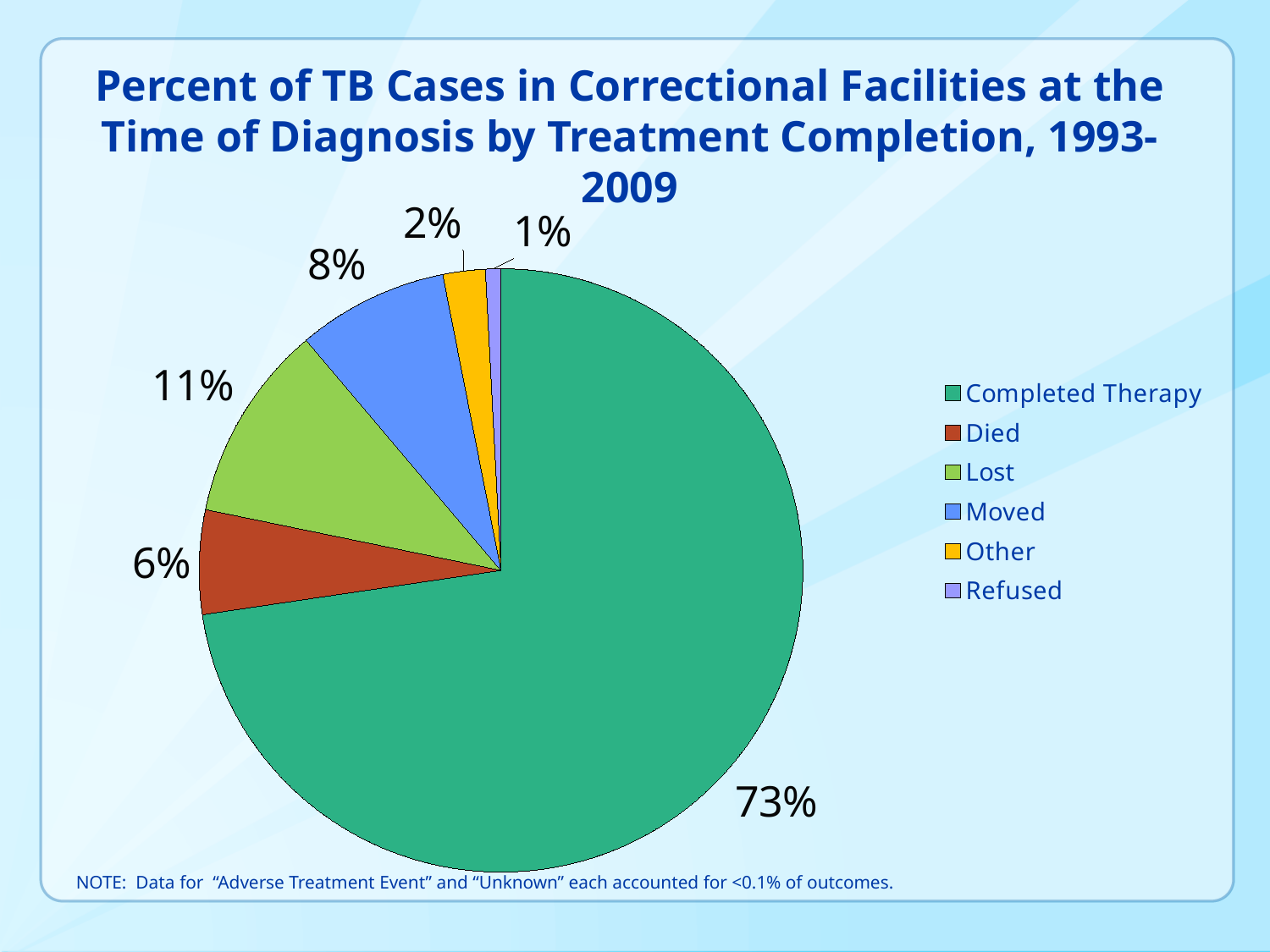
What colour is the Other slice of the pie? yellow What percentage of cases is labelled as Moved? 8% What percentage of cases is labelled as Died? 6% What percentage of TB cases in correctional facilities completed therapy? 73% What percentage of cases is labelled as Refused? 1% What is the difference in percentage points between the Lost and Moved slices? 3 How many categories does the legend list? 6 What kind of chart is shown on the slide? pie chart What percentage of cases is labelled as Lost? 11% Which slice is larger, Died or Moved? Moved Which treatment outcome category has the largest share of the pie? Completed Therapy Which treatment outcome category has the smallest share of the pie? Refused